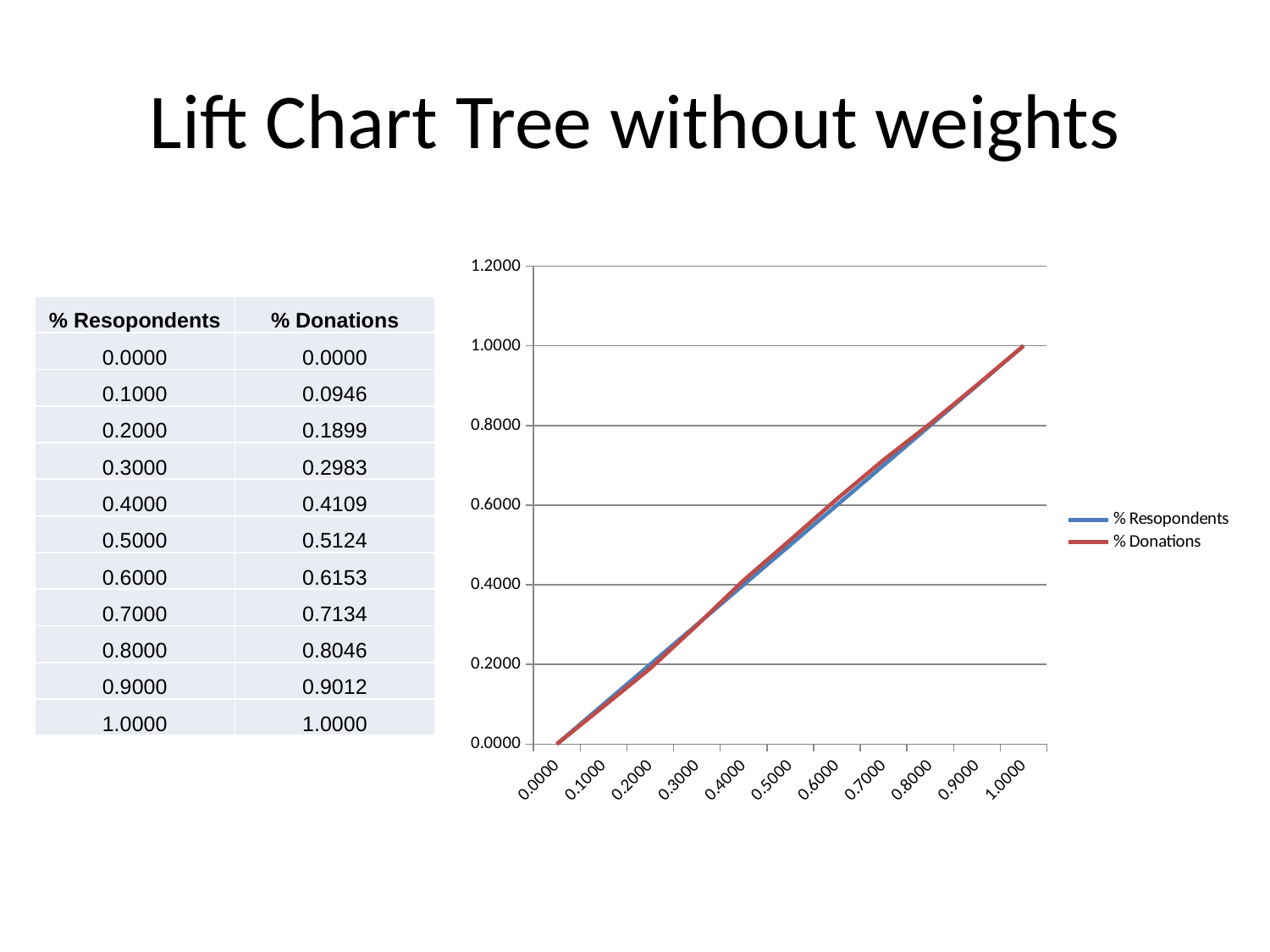
What is the % Donations value at 0.2000 on the x axis? 0.1899 Do the % Donations values rise or fall as the x axis increases from 0.0000 to 1.0000? rise What are the two series named in the chart's legend? % Resopondents and % Donations What is the difference between the % Donations value at 0.9000 and at 0.1000? 0.8066 What is the % Donations value at 0.8000 on the x axis? 0.8046 Is the % Donations value at 0.3000 greater or less than 0.4000? less At which x-axis value does % Donations reach its highest value? 1.0000 Is the % Donations value at 0.8000 greater or less than 0.6000? greater What kind of chart is shown on the slide? line chart What is the % Donations value at 0.5000 on the x axis? 0.5124 How many points are labelled along the x axis of the chart? 11 How many series does the chart's legend list? 2